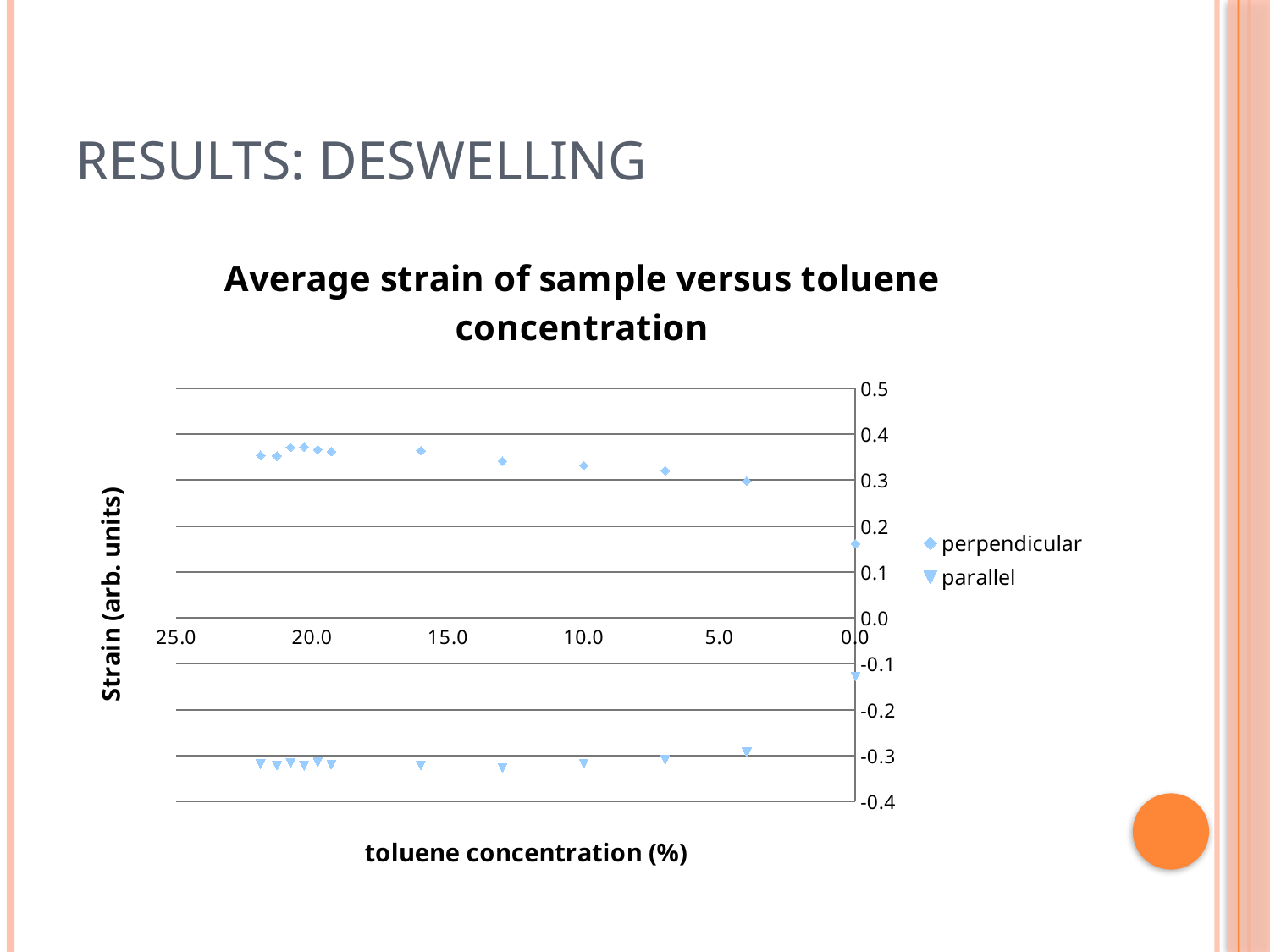
Is the parallel strain at a toluene concentration of 0.0% greater or less than 0.0? less At a toluene concentration of 15.0%, which series has the larger strain value, perpendicular or parallel? perpendicular Do the perpendicular strain values rise or fall as the toluene concentration decreases from 20.0% to 0.0%? fall Is the perpendicular strain at a toluene concentration of 20.0% greater or less than 0.3? greater How many series does the legend list? 2 Do the parallel strain values rise or fall as the toluene concentration decreases from 20.0% to 0.0%? rise What are the two series named in the legend? perpendicular and parallel Is the perpendicular strain at a toluene concentration of 15.0% greater or less than 0.3? greater What kind of chart is shown on the slide? scatter chart What is the title of the chart? Average strain of sample versus toluene concentration